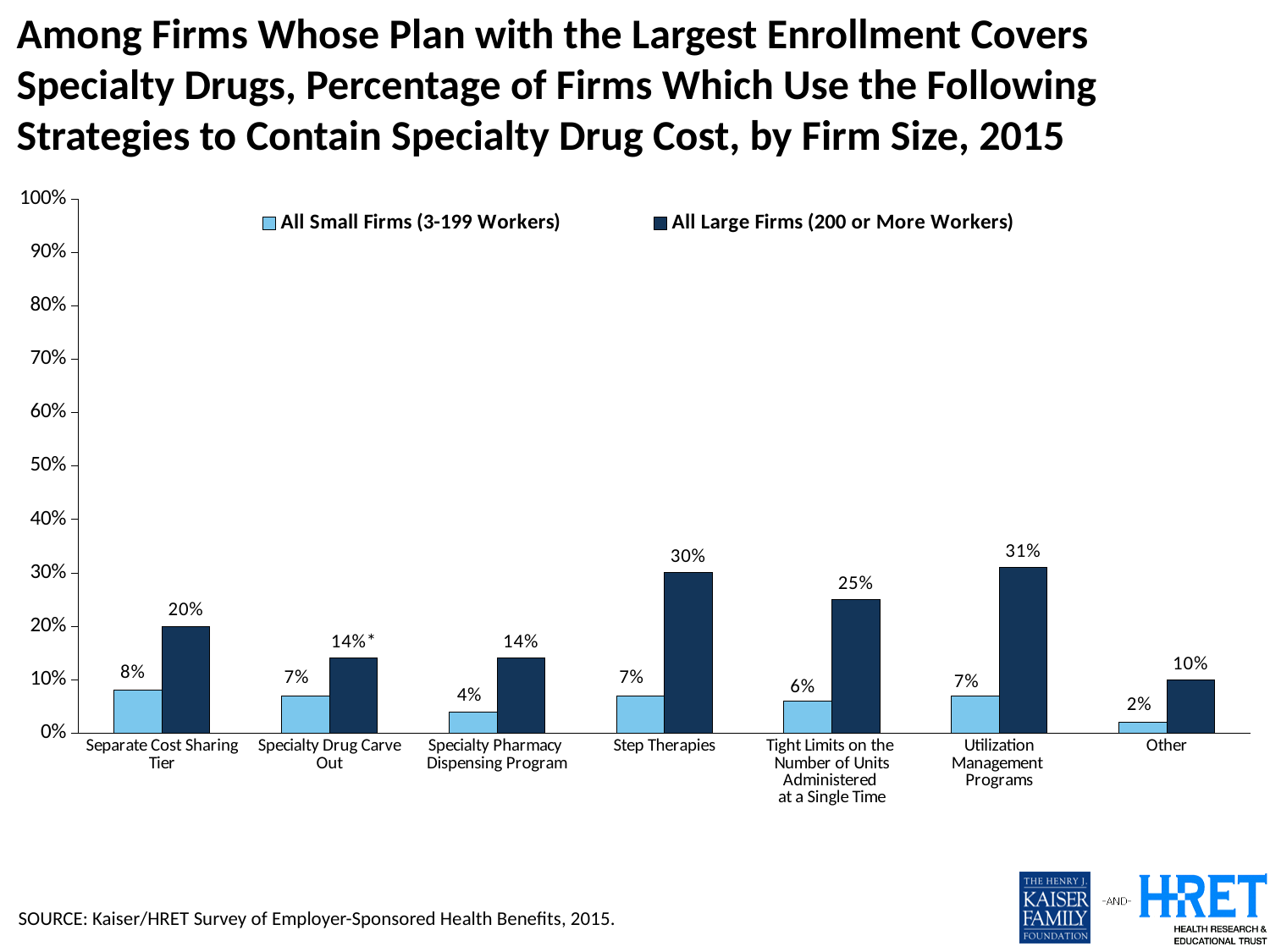
What percentage of All Large Firms (200 or More Workers) use Step Therapies? 30% Which data label on the chart is marked with an asterisk? 14%* (All Large Firms, Specialty Drug Carve Out) What percentage of All Large Firms (200 or More Workers) use Utilization Management Programs? 31% What is the difference between All Large Firms and All Small Firms for Tight Limits on the Number of Units Administered at a Single Time? 19% Which strategy has the highest value for All Large Firms (200 or More Workers)? Utilization Management Programs Is the value for All Large Firms for Step Therapies greater or less than 20%? greater What percentage of All Small Firms (3-199 Workers) use a Specialty Pharmacy Dispensing Program? 4% How many series does the legend list? 2 For Separate Cost Sharing Tier, which is larger: the value for All Small Firms or All Large Firms? All Large Firms (200 or More Workers) Which strategy has the lowest value for All Small Firms (3-199 Workers)? Other How many strategy categories are shown on the x axis? 7 What kind of chart is shown on the slide? Bar chart